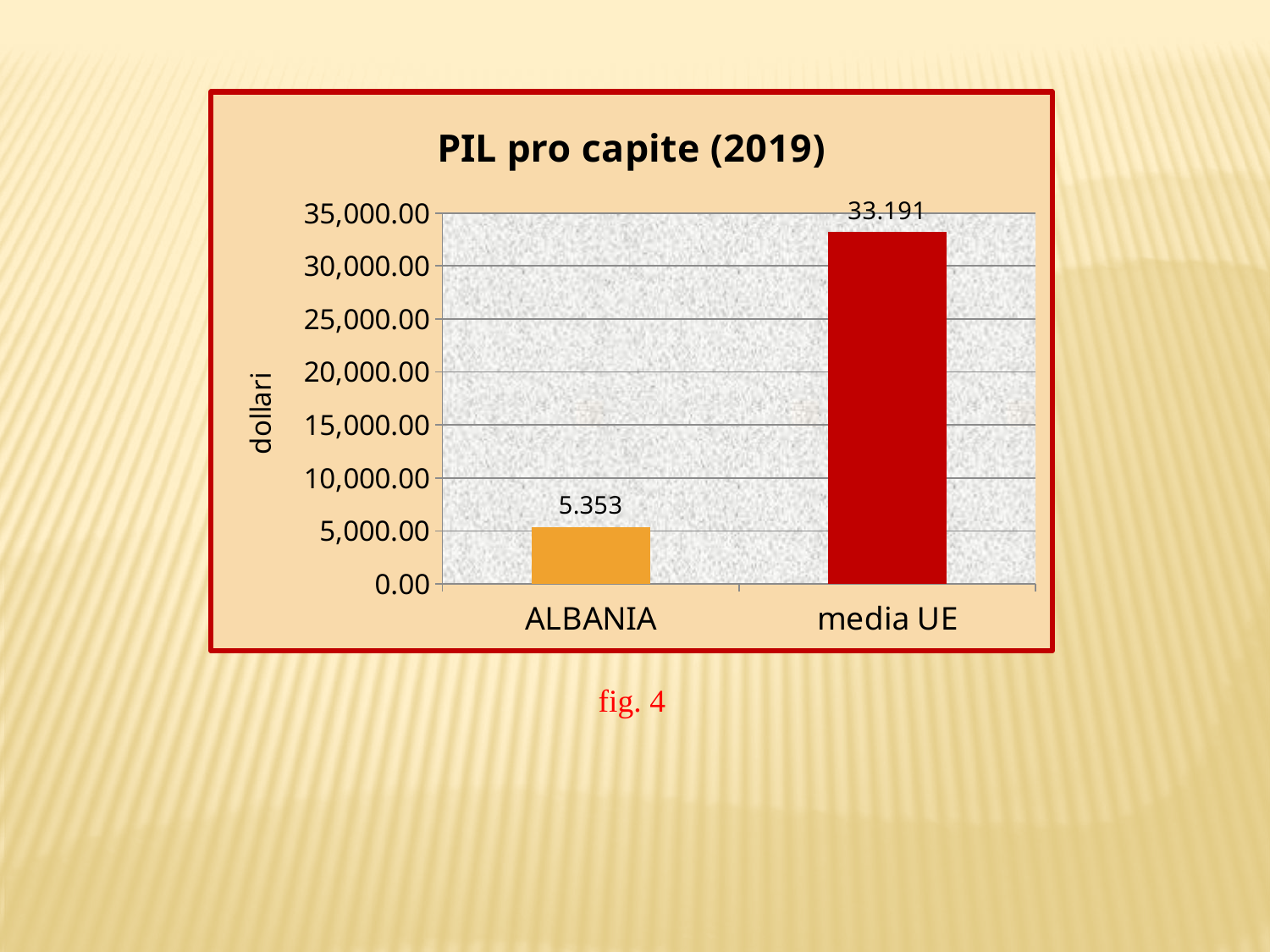
What is the label of the vertical axis in the PIL pro capite (2019) chart? dollari Is the value for ALBANIA greater or less than 10,000.00 in the PIL pro capite (2019) chart? less How many categories are shown in the PIL pro capite (2019) chart? 2 Is the value for media UE greater or less than 30,000.00 in the PIL pro capite (2019) chart? greater What is the difference between the media UE value and the ALBANIA value in the PIL pro capite (2019) chart? 27.838 What is the value for ALBANIA in the PIL pro capite (2019) chart? 5.353 What is the value for media UE in the PIL pro capite (2019) chart? 33.191 What kind of chart is the PIL pro capite (2019) chart? bar chart Which category has the lowest value in the PIL pro capite (2019) chart? ALBANIA What is the title of the chart on the slide? PIL pro capite (2019) Which category has the highest value in the PIL pro capite (2019) chart? media UE Which is larger in the PIL pro capite (2019) chart, the value for ALBANIA or the value for media UE? media UE